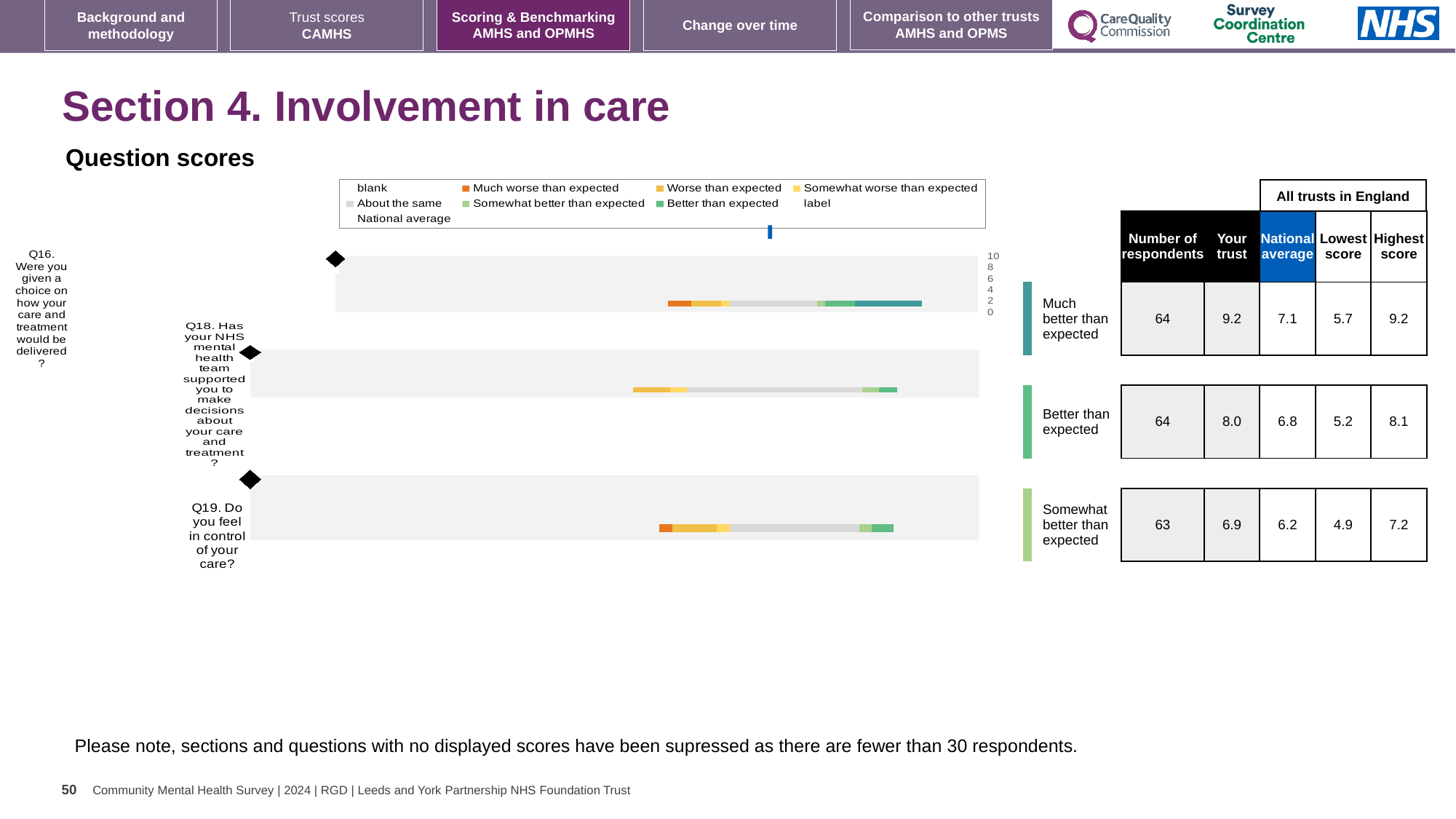
What is the national average score for Q18 (Has your NHS mental health team supported you to make decisions about your care and treatment?)? 6.8 How many respondents answered Q19 (Do you feel in control of your care?)? 63 What is the highest score among all trusts in England for Q19? 7.2 Which question has the highest 'Your trust' score? Q16 For Q18, which is larger: the 'Your trust' score or the national average? Your trust What is the 'Your trust' score for Q16 (Were you given a choice on how your care and treatment would be delivered?)? 9.2 What is the difference between the 'Your trust' score and the national average for Q16? 2.1 Which benchmark category is Q16 placed in? Much better than expected Which question has the lowest 'Your trust' score? Q19 How many questions are plotted in the question scores chart? 3 What kind of chart is used to show the question scores on this slide? bar chart What is the lowest score among all trusts in England for Q18? 5.2